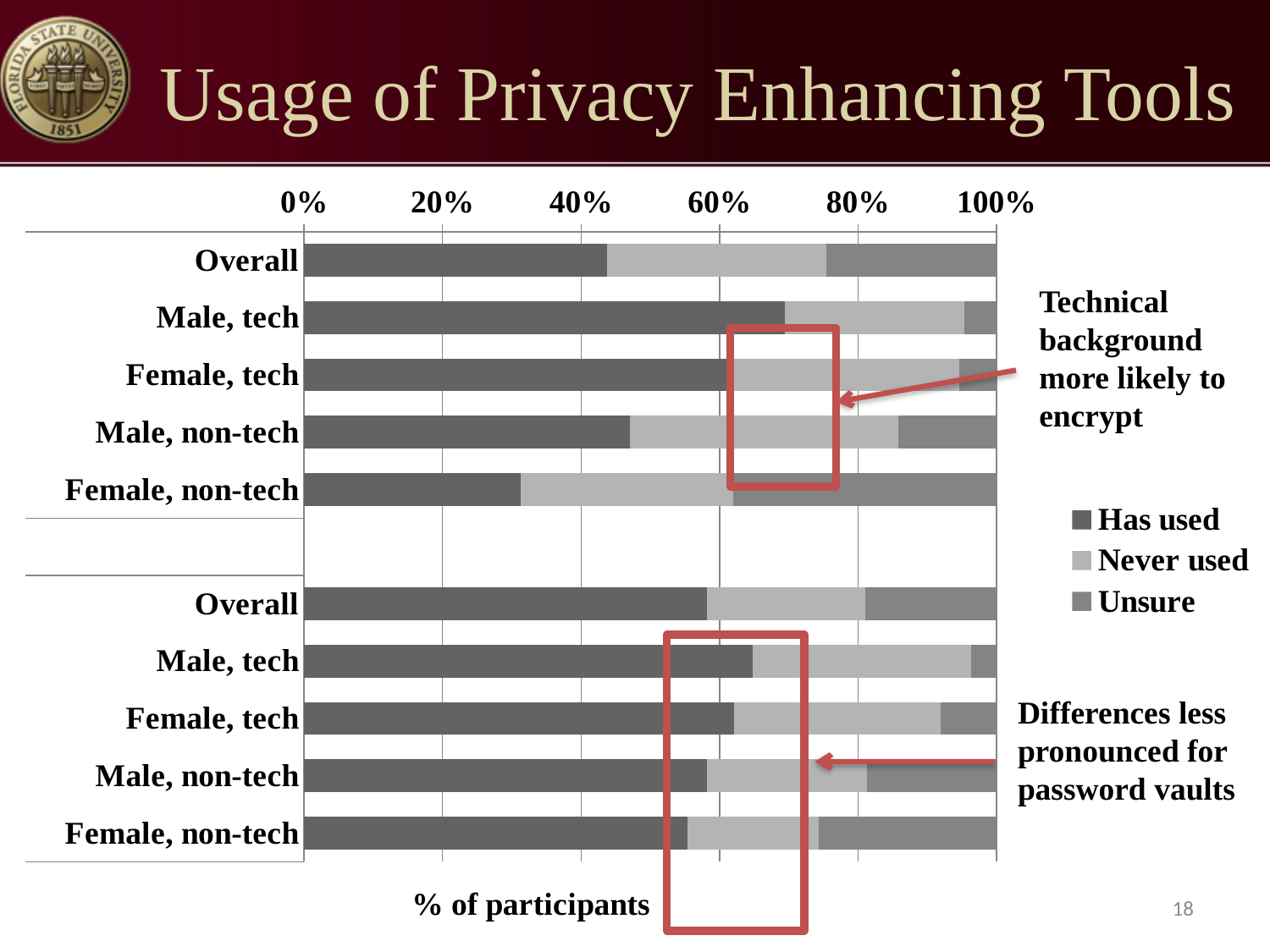
In the upper group of bars, which category has the smallest 'Has used' share? Female, non-tech In the upper group of bars, is the 'Has used' value for Male, tech greater or less than 60%? greater In the upper group of bars, is the 'Has used' value for Female, non-tech greater or less than 40%? less In the lower group of bars, which category has the largest 'Has used' share? Male, tech How many series does the legend list? 3 In the upper group of bars, which has a larger 'Has used' share: Male, tech or Female, non-tech? Male, tech What are the three legend entries? Has used, Never used, Unsure What is the x-axis title of the chart? % of participants What kind of chart is shown on the slide? Stacked bar chart In the lower group of bars, is the 'Has used' value for Male, tech greater or less than 60%? greater How many bars are plotted in total across both groups of the chart? 10 In the upper group of bars, which category has the largest 'Has used' share? Male, tech